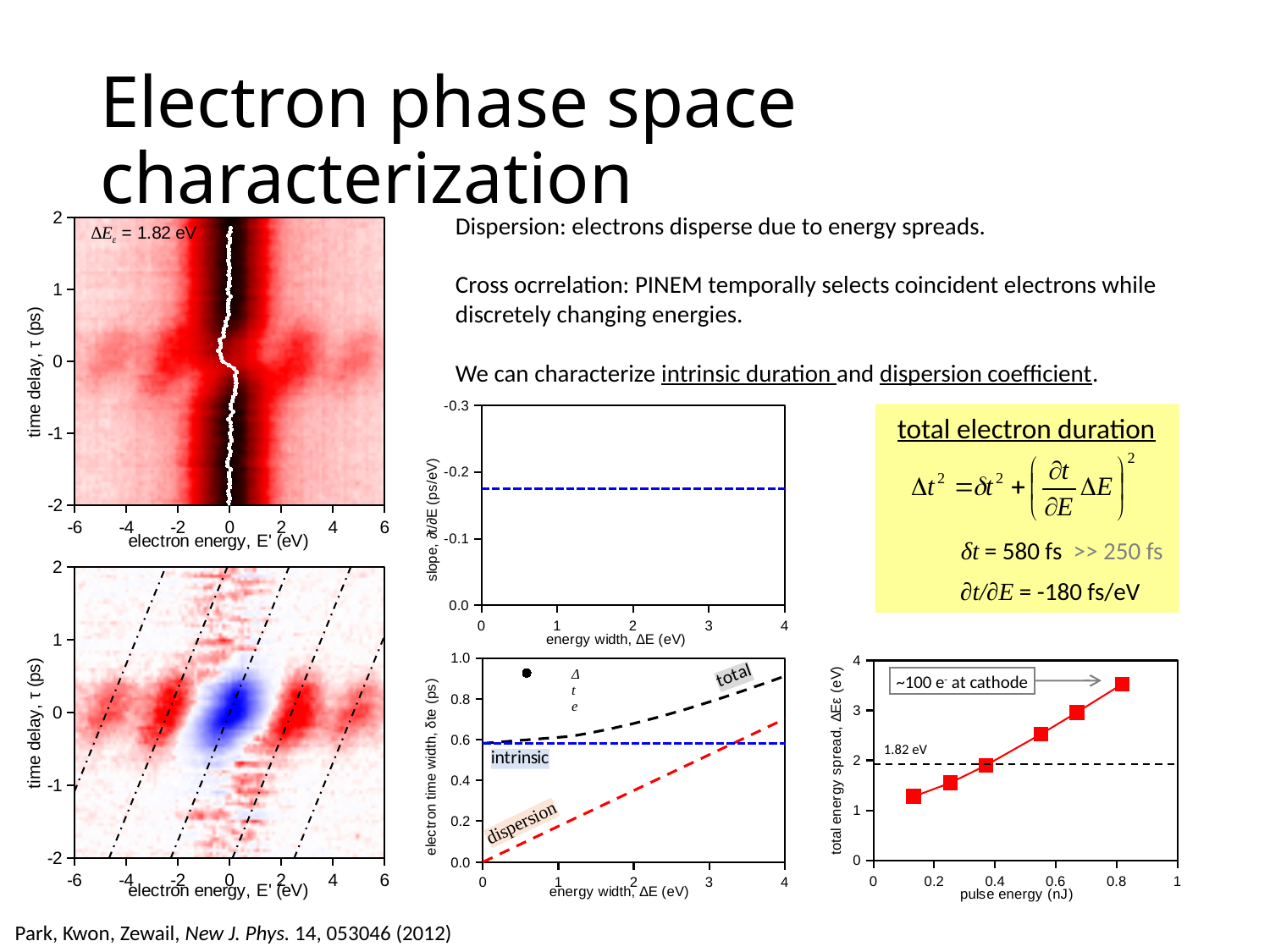
In the middle-bottom chart of electron time width versus energy width, at an energy width of 4 eV, which curve is higher: total or dispersion? total In the bottom-right chart of total energy spread versus pulse energy, do the values rise or fall as pulse energy increases? rise In the bottom-right chart of total energy spread versus pulse energy, how many data points are plotted? 6 In the bottom-right chart of total energy spread versus pulse energy, what value is the horizontal dashed line labelled with? 1.82 eV In the bottom-right chart of total energy spread versus pulse energy, is the total energy spread at the highest pulse energy greater or less than 3? greater In the bottom-right chart of total energy spread versus pulse energy, what is the x-axis label? pulse energy (nJ) In the middle-bottom chart of electron time width versus energy width, how many labelled curves are shown? 3 In the middle-bottom chart of electron time width versus energy width, which labelled curve stays flat across the energy width range? intrinsic In the bottom-right chart of total energy spread versus pulse energy, is the total energy spread at the lowest pulse energy greater or less than 2? less In the bottom-right chart of total energy spread versus pulse energy, does the highest total energy spread occur at the lowest or the highest pulse energy? highest In the middle-bottom chart of electron time width versus energy width, is the dispersion curve at an energy width of 4 eV greater or less than 0.6? greater In the middle-top chart, what is the y-axis label? slope, ∂t/∂E (ps/eV)